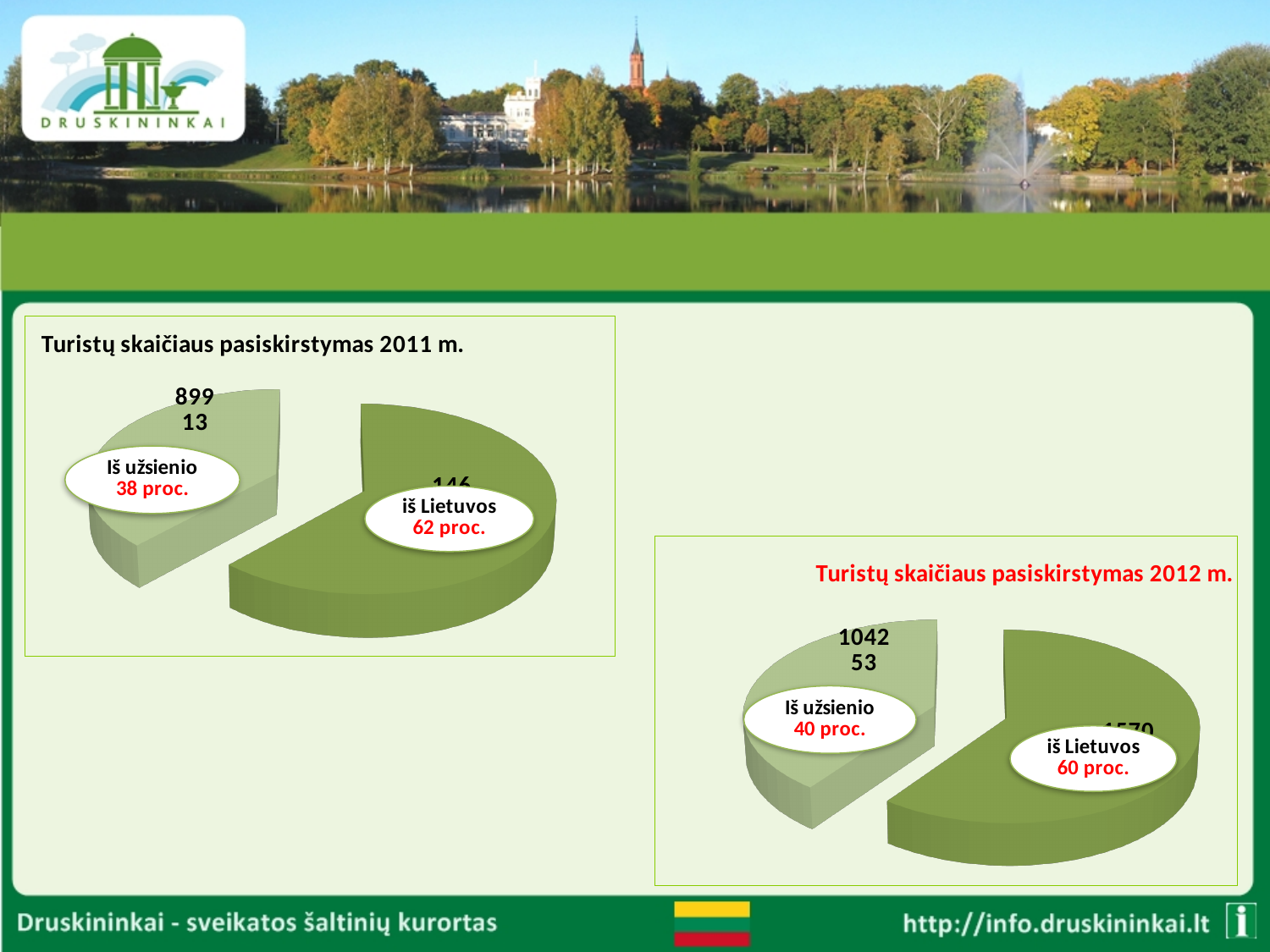
What is the difference in percentage points between the 'iš Lietuvos' and 'Iš užsienio' shares in the chart 'Turistų skaičiaus pasiskirstymas 2012 m.'? 20 proc. How many slices does the chart 'Turistų skaičiaus pasiskirstymas 2011 m.' have? 2 In the chart 'Turistų skaičiaus pasiskirstymas 2012 m.', what share of tourists is 'iš Lietuvos'? 60 proc. What type of chart is used in 'Turistų skaičiaus pasiskirstymas 2011 m.'? Pie chart In the chart 'Turistų skaičiaus pasiskirstymas 2012 m.', what share of tourists is 'Iš užsienio'? 40 proc. In the chart 'Turistų skaičiaus pasiskirstymas 2011 m.', which slice is larger, 'Iš užsienio' or 'iš Lietuvos'? iš Lietuvos In the chart 'Turistų skaičiaus pasiskirstymas 2011 m.', what share of tourists is 'iš Lietuvos'? 62 proc. What is the title of the chart in the lower right of the slide? Turistų skaičiaus pasiskirstymas 2012 m. How many pie charts are shown on the slide? 2 In the chart 'Turistų skaičiaus pasiskirstymas 2012 m.', which slice is the smallest? Iš užsienio In the chart 'Turistų skaičiaus pasiskirstymas 2012 m.', which slice is the largest? iš Lietuvos